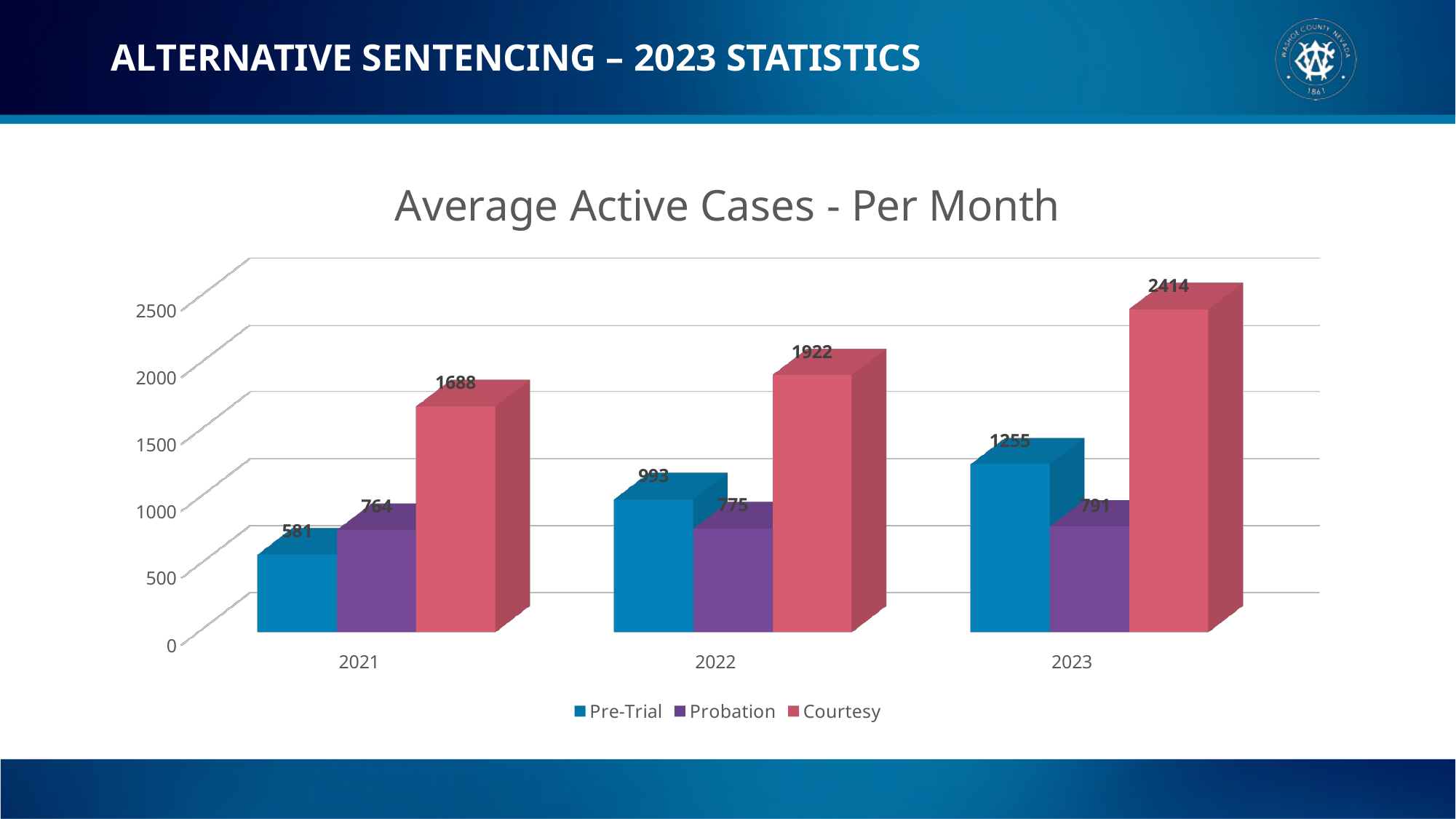
What is the Courtesy value for 2023? 2414 What is the difference between the Pre-Trial and Probation values for 2023? 464 Which year has the lowest Courtesy value? 2021 Do the Pre-Trial values rise or fall from 2021 to 2023? rise What is the Probation value for 2022? 775 What is the Pre-Trial value for 2021? 581 Which year has the highest Pre-Trial value? 2023 What is the difference between the Courtesy values for 2023 and 2022? 492 How many years are shown on the x axis? 3 Which is larger in 2021, Pre-Trial or Probation? Probation Is the Courtesy value for 2022 greater or less than 1500? greater How many series does the legend list? 3